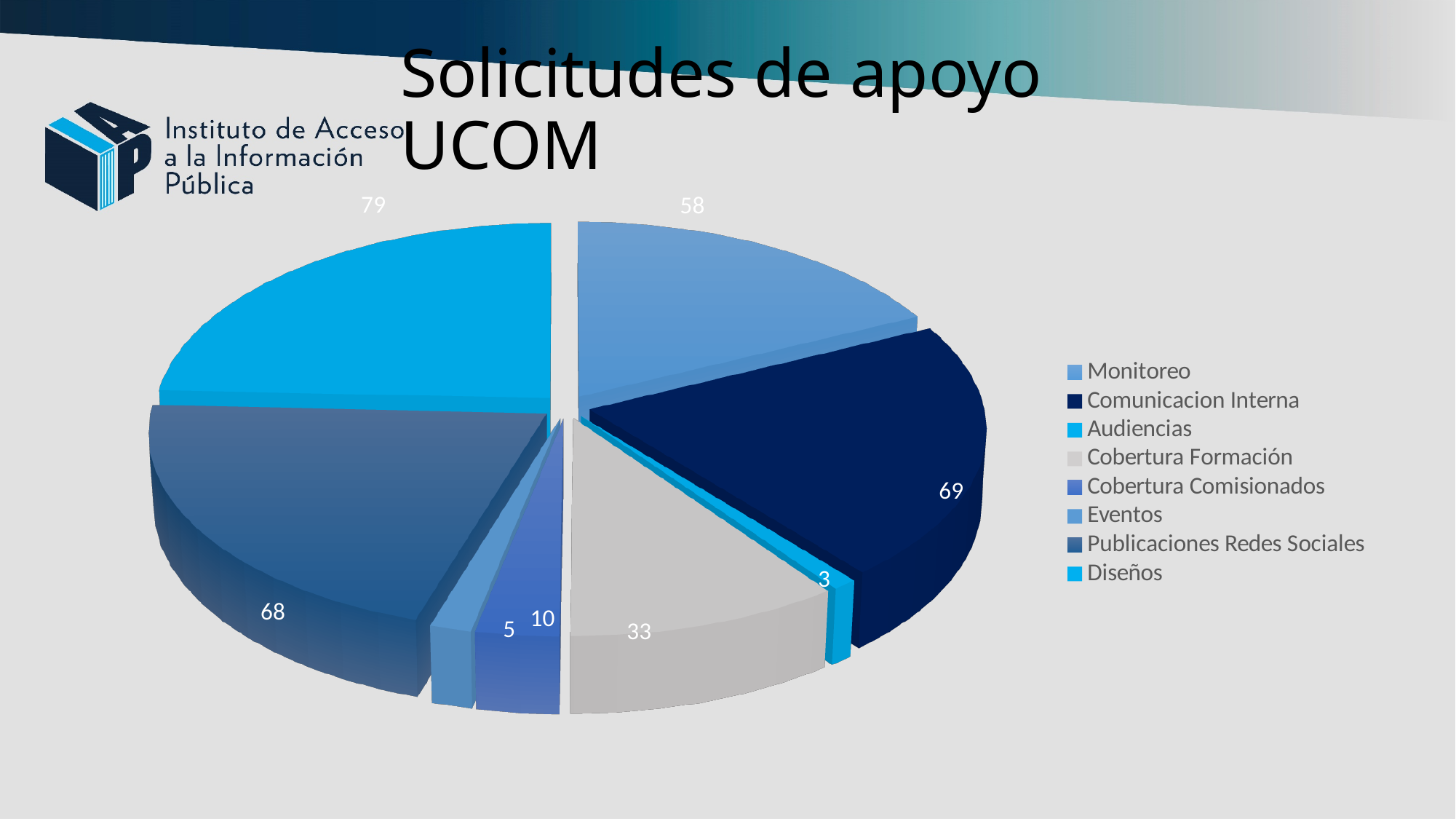
What is the value for Eventos? 5 What is the value for Comunicacion Interna? 69 What is the difference between the values for Comunicacion Interna and Monitoreo? 11 Which is larger, the value for Cobertura Comisionados or the value for Eventos? Cobertura Comisionados What is the title of the chart on the slide? Solicitudes de apoyo UCOM How many categories does the legend of the pie chart list? 8 What is the value for Cobertura Formación? 33 What is the value for Cobertura Comisionados? 10 Which is larger, the value for Publicaciones Redes Sociales or the value for Cobertura Formación? Publicaciones Redes Sociales What type of chart is shown on the slide? Pie chart What is the value for Publicaciones Redes Sociales? 68 What is the value for Monitoreo? 58